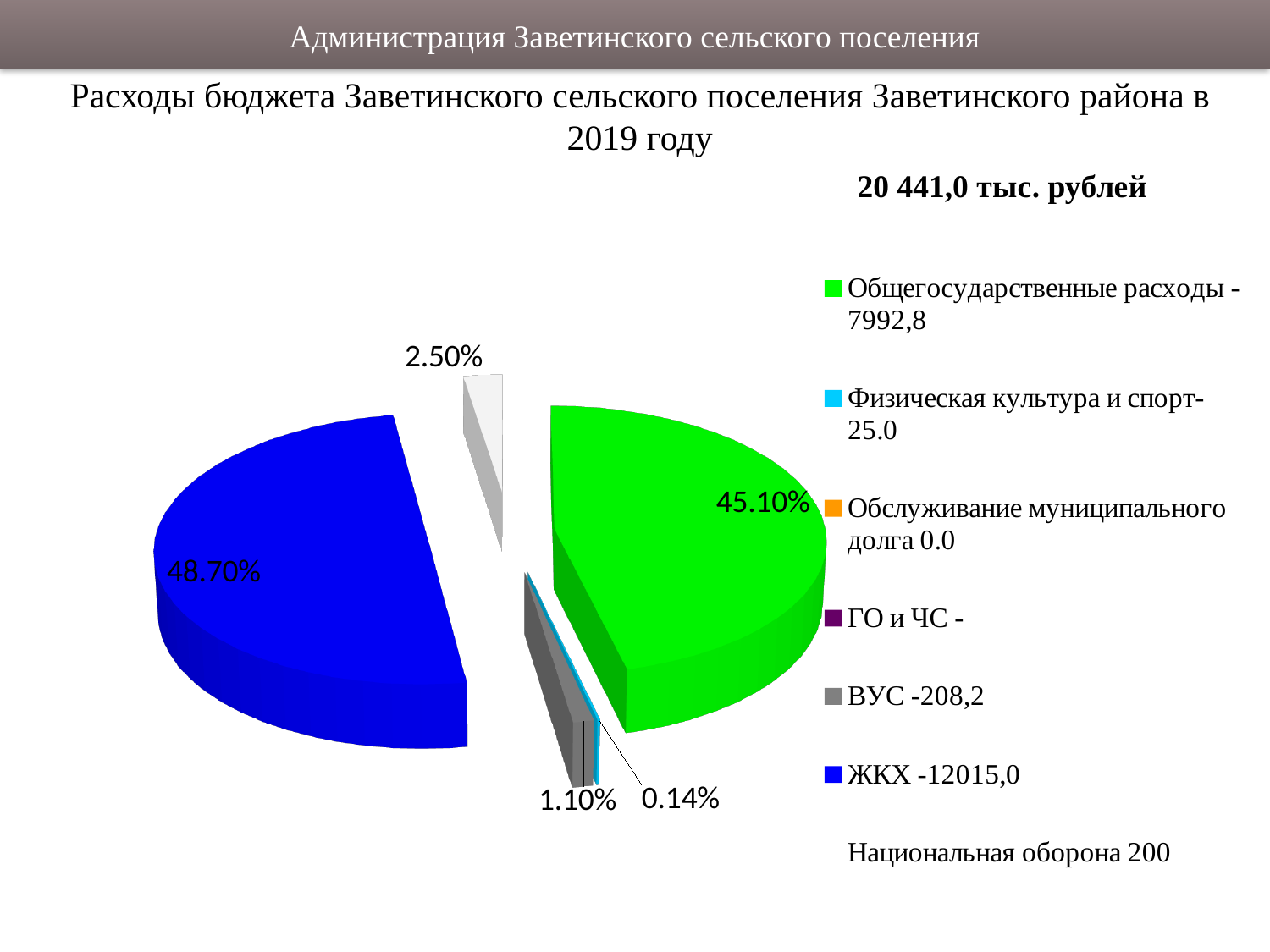
Which is larger, the share for ЖКХ or the share for Общегосударственные расходы? ЖКХ What kind of chart is shown on the slide? pie chart What colour is the ЖКХ slice in the pie chart? blue Which category has the largest slice of the pie? ЖКХ What amount is given for ЖКХ in the legend? 12015,0 What share of the pie does Физическая культура и спорт account for? 0.14% Which category has the smallest labelled slice of the pie? Физическая культура и спорт What share of the pie does ЖКХ account for? 48.70% What share of the pie does ВУС account for? 1.10% What is the difference in percentage points between the ЖКХ slice and the Общегосударственные расходы slice? 3.60% How many entries does the legend list? 7